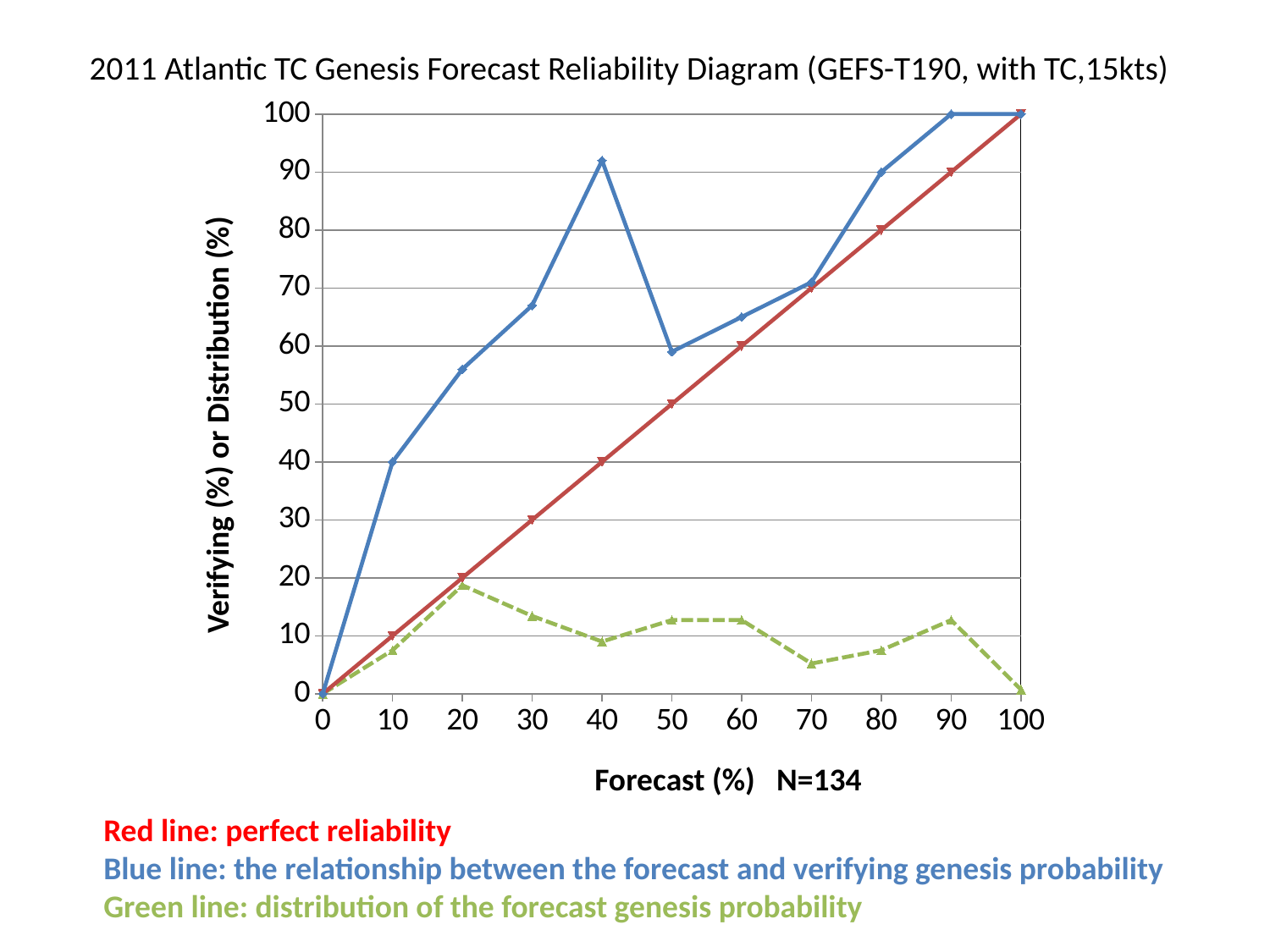
Is the value of the green line at a forecast of 70% greater or less than 10? less What is the value of the blue line at a forecast of 10%? 40 What is the value of the blue line at a forecast of 90%? 100 What kind of chart is shown on the slide? line chart Is the value of the blue line at a forecast of 50% greater or less than 70? less What is the sample size N shown on the x-axis label? N=134 What is the value of the red line at a forecast of 50%? 50 Which is larger for the blue line: the value at a forecast of 40% or at 50%? 40% At which forecast (%) does the green line reach its highest value? 20 Is the value of the blue line at a forecast of 40% greater or less than 80? greater How many lines are plotted on the chart? 3 How many forecast (%) points are marked along the x axis? 11